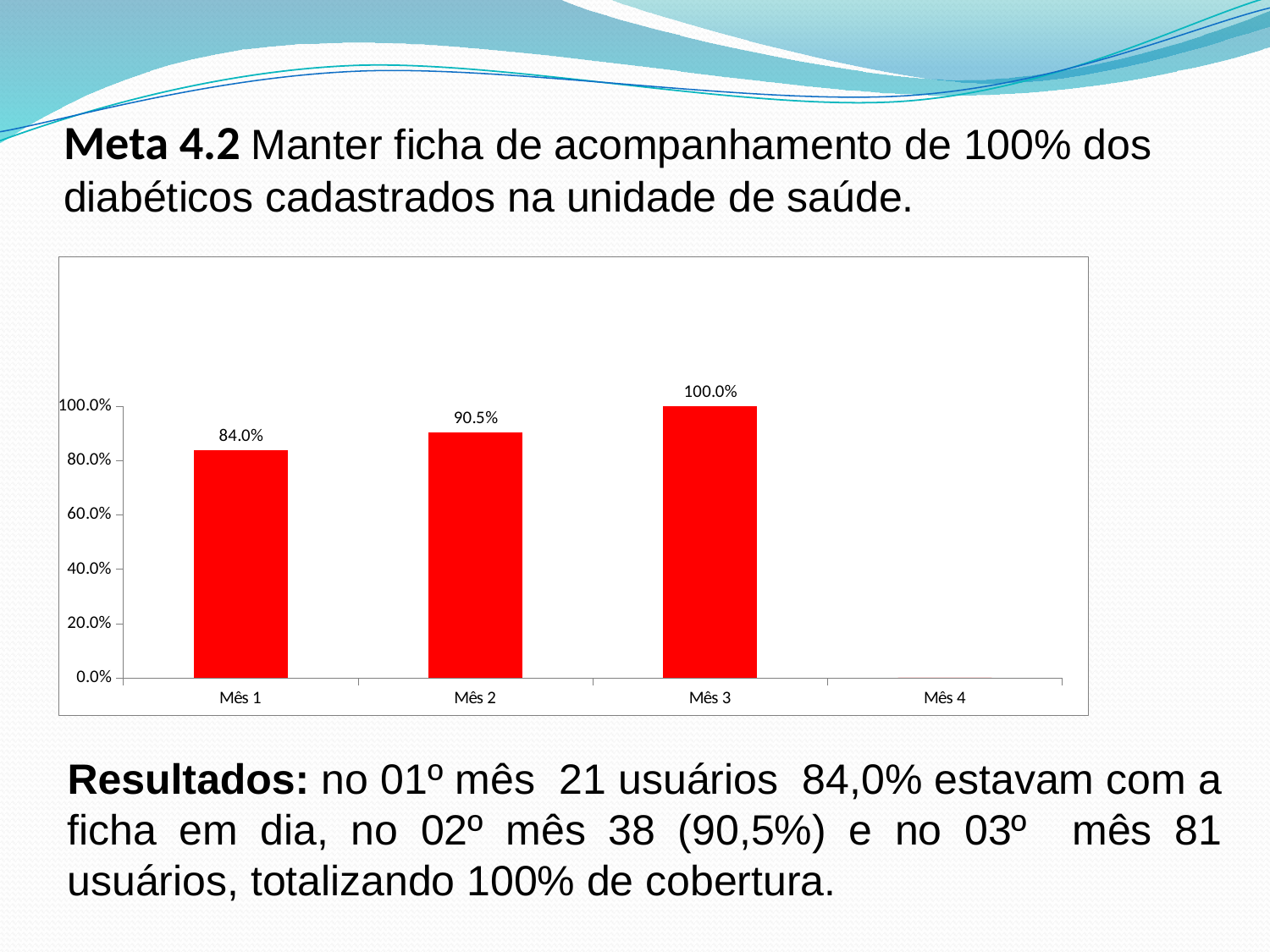
Do the values rise or fall from Mês 1 to Mês 3? rise What kind of chart is shown on the slide? bar chart What is the difference between the values for Mês 3 and Mês 1? 16.0% What is the value for Mês 3? 100.0% Which is larger, the value for Mês 1 or the value for Mês 2? Mês 2 Which month has the highest value among the bars shown? Mês 3 What is the value for Mês 2? 90.5% Which month has the lowest value among the bars with data labels? Mês 1 Is the value for Mês 1 greater or less than 80.0%? greater What is the value for Mês 1? 84.0% What is the difference between the values for Mês 2 and Mês 1? 6.5% How many categories are shown on the x axis? 4